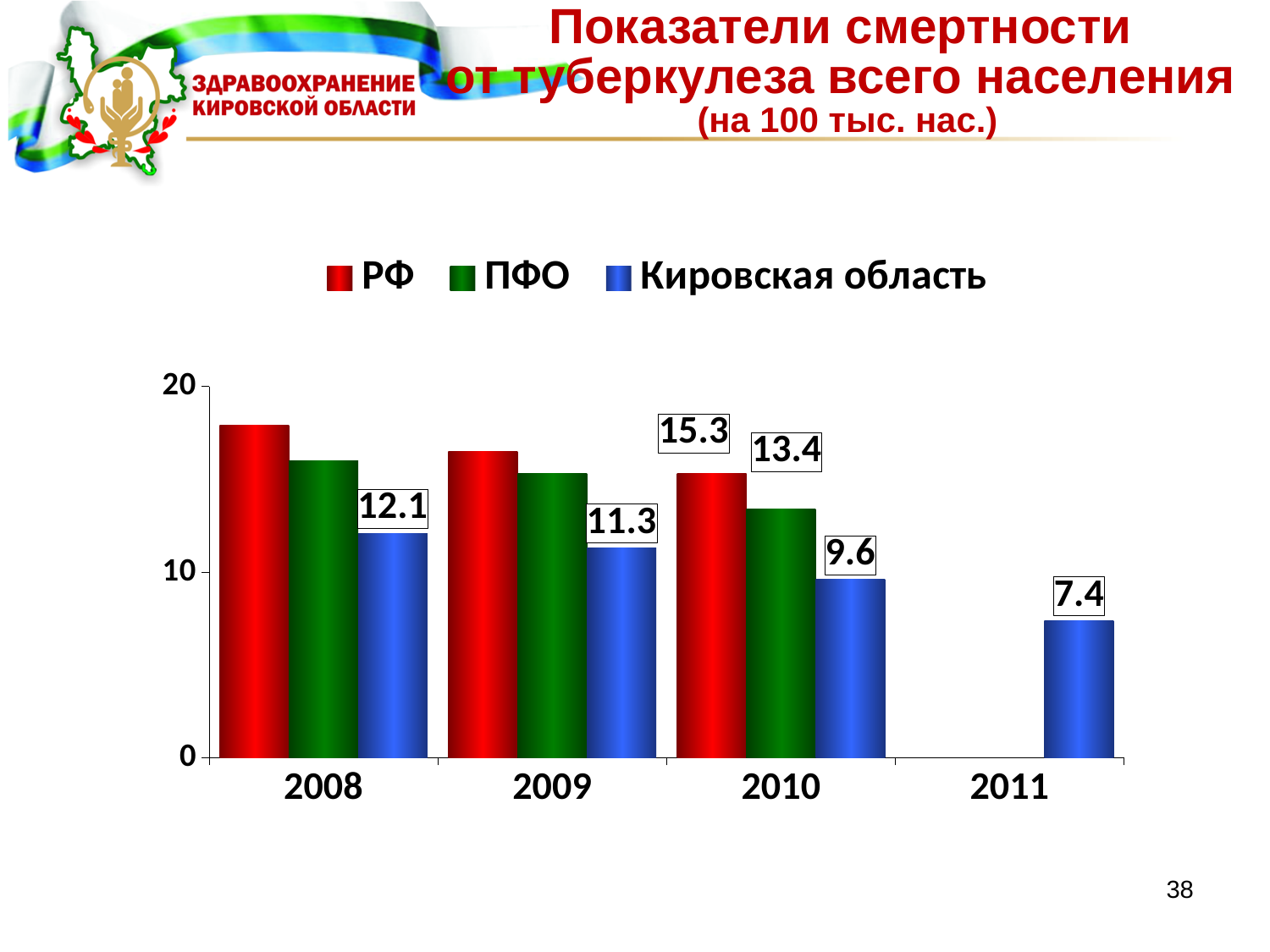
By how much did the Кировская область value fall from 2008 to 2011? 4.7 What is the value for Кировская область in 2011? 7.4 How many years are shown on the x axis? 4 What is the value for ПФО in 2010? 13.4 How many series does the legend list? 3 In which year is the Кировская область value lowest? 2011 What is the value for Кировская область in 2008? 12.1 Is the value for РФ in 2008 greater or less than 10? greater What is the value for РФ in 2010? 15.3 What kind of chart is shown on the slide? bar chart Do the values for Кировская область rise or fall from 2008 to 2011? fall What is the difference between the РФ value and the Кировская область value in 2010? 5.7